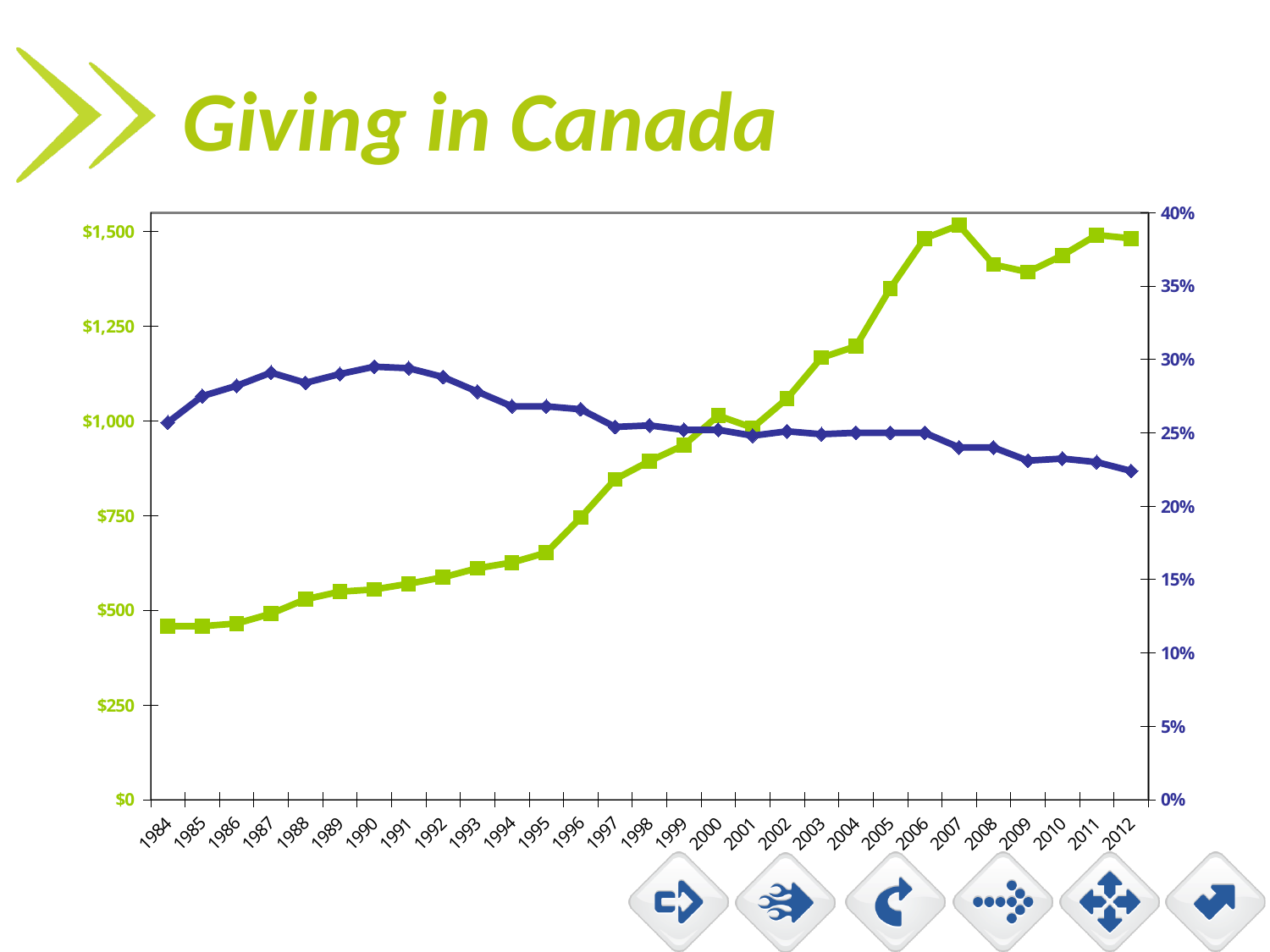
Is the value of the green line for 2005 greater or less than $1,250? greater What kind of chart is shown on the slide? line chart What is the title of the slide containing the chart? Giving in Canada On the green line, which year has the larger value, 1990 or 2000? 2000 Does the green line generally rise or fall from 1984 to 2012? rise How many years are plotted along the x axis of the chart? 29 On the blue line, which year has the larger value, 1987 or 2008? 1987 Does the blue line generally rise or fall from 1990 to 2012? fall Is the value of the green line for 1984 greater or less than $500? less Is the value of the blue line for 2009 greater or less than 25%? less Which year has the lowest value on the blue line (right percentage axis)? 2012 Which year has the highest value on the green line (left dollar axis)? 2007